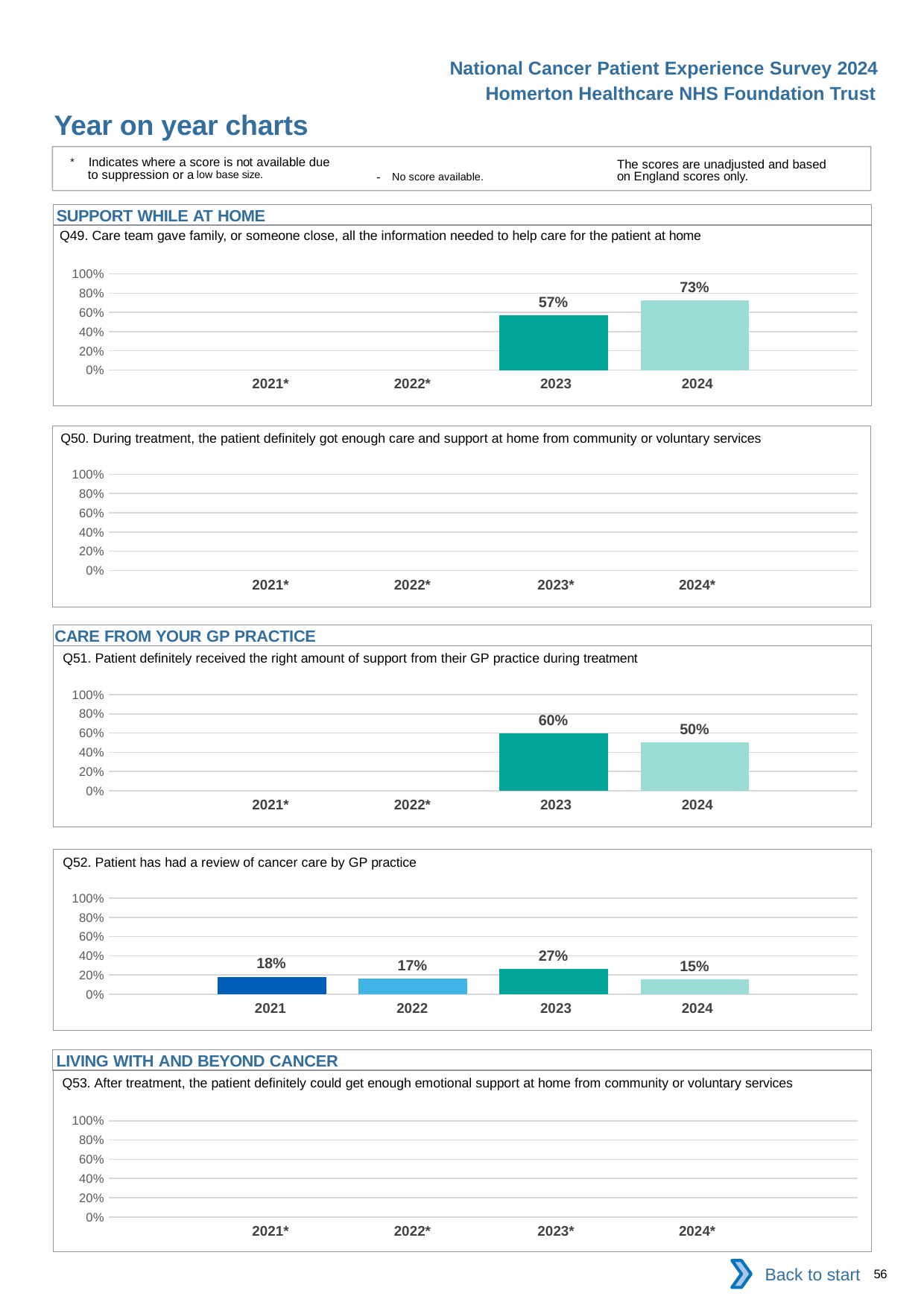
In the Q52 chart, how many years have a bar plotted? 4 In the Q52 chart, which year has the lowest value? 2024 In the Q51 chart, which year has the higher value, 2023 or 2024? 2023 In the Q51 chart, what is the difference between the 2023 and 2024 values? 10% In the Q52 chart, what is the value for 2021? 18% What kind of chart is the Q52 chart? bar chart In the Q49 chart, what is the difference between the 2024 and 2023 values? 16% In the Q51 chart, what is the value for 2023? 60% In the Q52 chart, which year has the highest value? 2023 In the Q49 chart, what is the value for 2023? 57% In the Q49 chart, what is the value for 2024? 73% In the Q50 chart, how many years have a bar plotted? 0